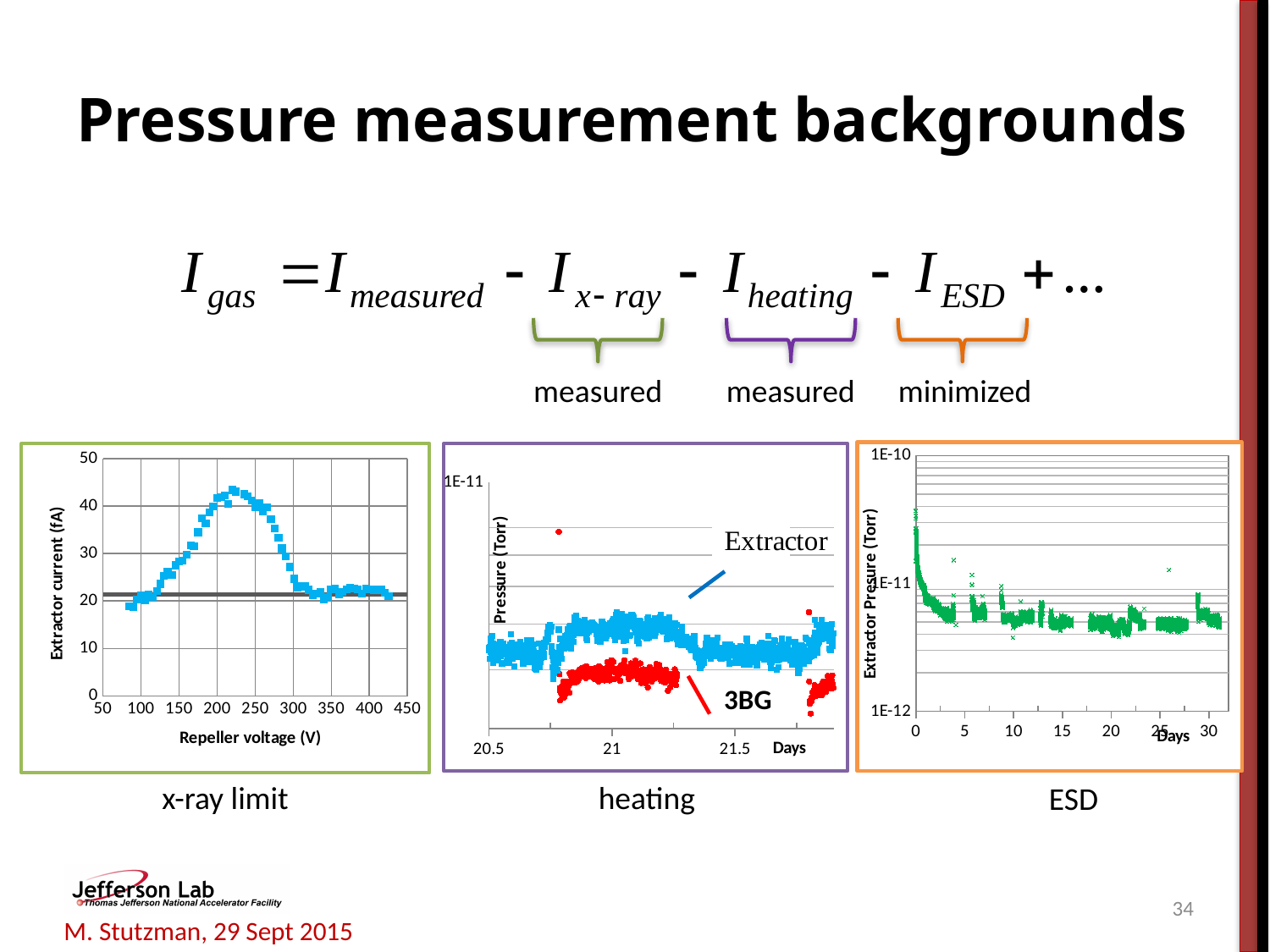
How many charts are shown on the slide? 3 In the x-ray limit chart (left), what is the label of the x axis? Repeller voltage (V) In the ESD chart (right), is the extractor pressure at day 20 greater or less than 1E-11 Torr? less In the x-ray limit chart (left), is the extractor current at a repeller voltage of 400 V greater or less than 30 fA? less In the x-ray limit chart (left), is the extractor current at a repeller voltage of 200 V greater or less than 30 fA? greater In the heating chart (middle), what colour are the 3BG data points? red In the x-ray limit chart (left), does the extractor current rise or fall as the repeller voltage increases from 250 V to 350 V? fall In the heating chart (middle), which series shows the higher pressure, Extractor or 3BG? Extractor In the x-ray limit chart (left), what is the label of the y axis? Extractor current (fA) In the heating chart (middle), how many data series are plotted? 2 In the ESD chart (right), does the extractor pressure generally rise or fall over the first 5 days? fall